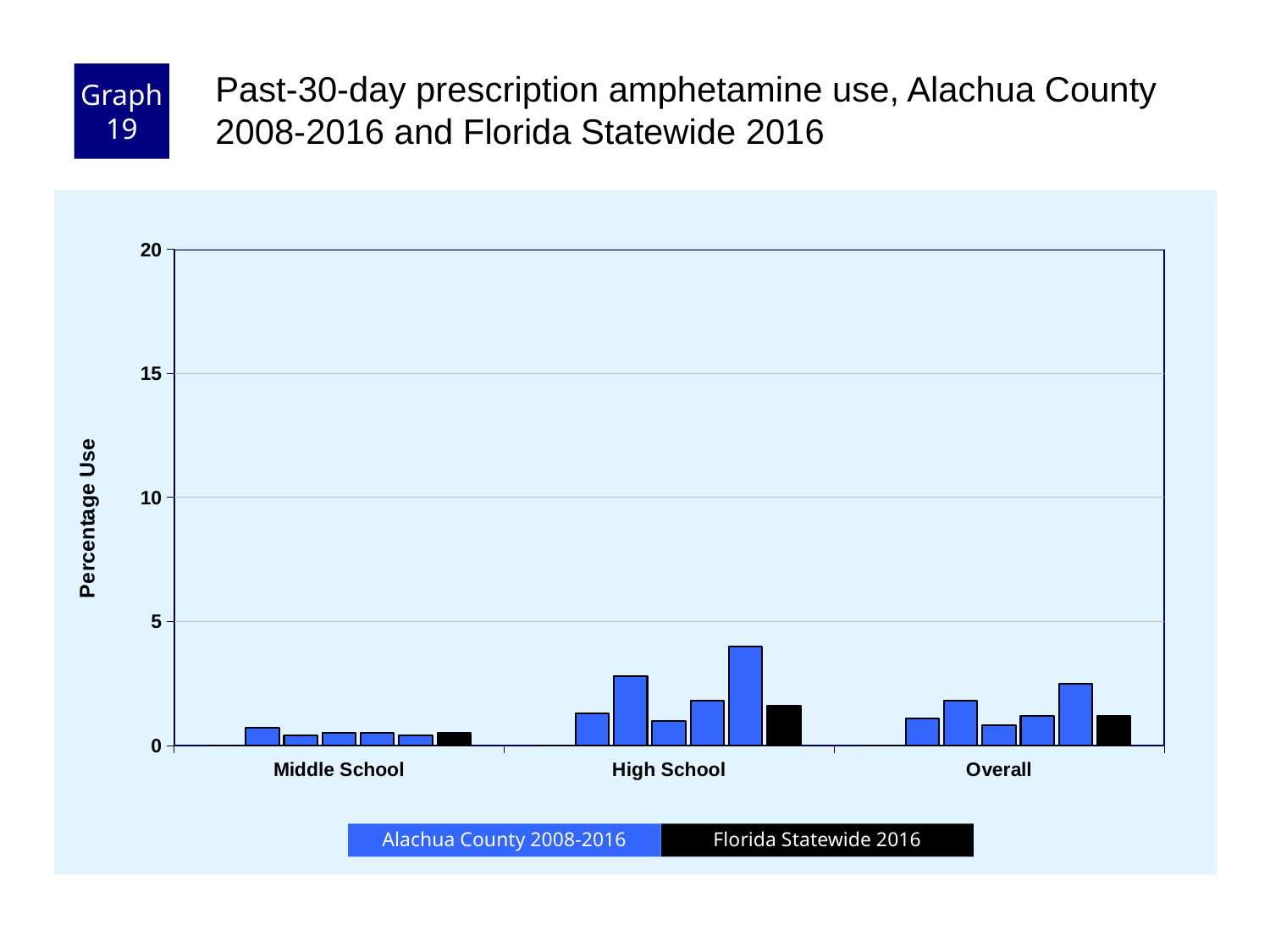
What kind of chart is shown on the slide? bar chart Which is larger: the tallest Alachua County bar in High School or the tallest Alachua County bar in Middle School? High School Which category has the lowest bars overall? Middle School Which category contains the tallest bar on the chart? High School Is the value for Florida Statewide 2016 in the High School category greater or less than 5? less What is the label on the y axis? Percentage Use Is the value for Florida Statewide 2016 in the Middle School category greater or less than 5? less How many categories are shown along the x axis? 3 How many series does the legend list? 2 Which series is shown in black in the legend? Florida Statewide 2016 Which is larger: the Florida Statewide 2016 bar for High School or the Florida Statewide 2016 bar for Middle School? High School Is the tallest bar in the High School category greater or less than 5? less